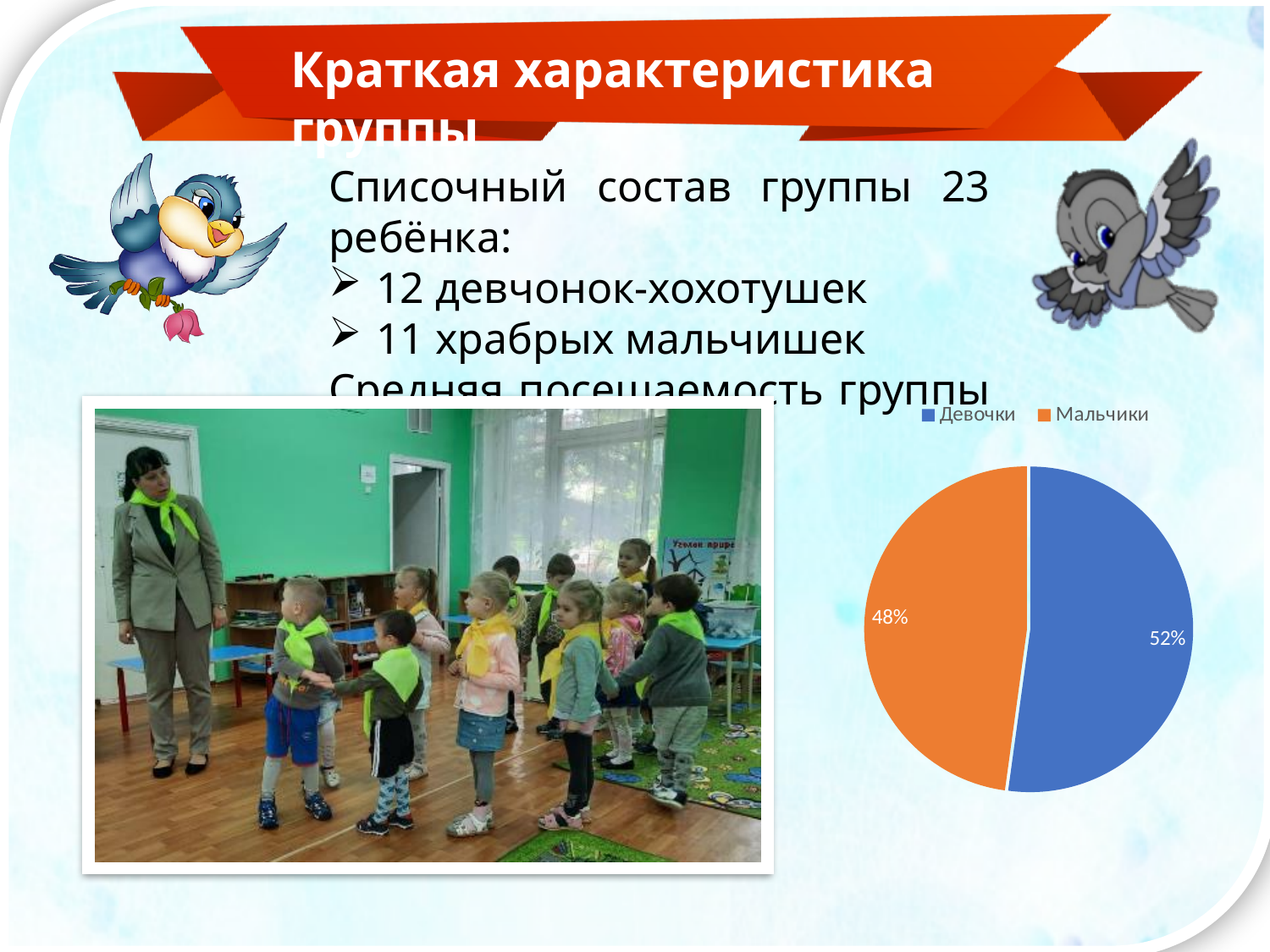
Which slice of the pie chart is the largest? Девочки What colour is the Мальчики slice in the pie chart? orange What share of the pie chart is labelled Мальчики? 48% How many slices does the pie chart have? 2 What share of the pie chart is labelled Девочки? 52% Which slice of the pie chart is the smallest? Мальчики Is the share for Мальчики greater or less than 50%? less By how many percentage points does the Девочки slice exceed the Мальчики slice? 4% Which is larger in the pie chart, Девочки or Мальчики? Девочки How many entries does the legend of the pie chart list? 2 What kind of chart is shown on the slide? pie chart What colour is the Девочки slice in the pie chart? blue